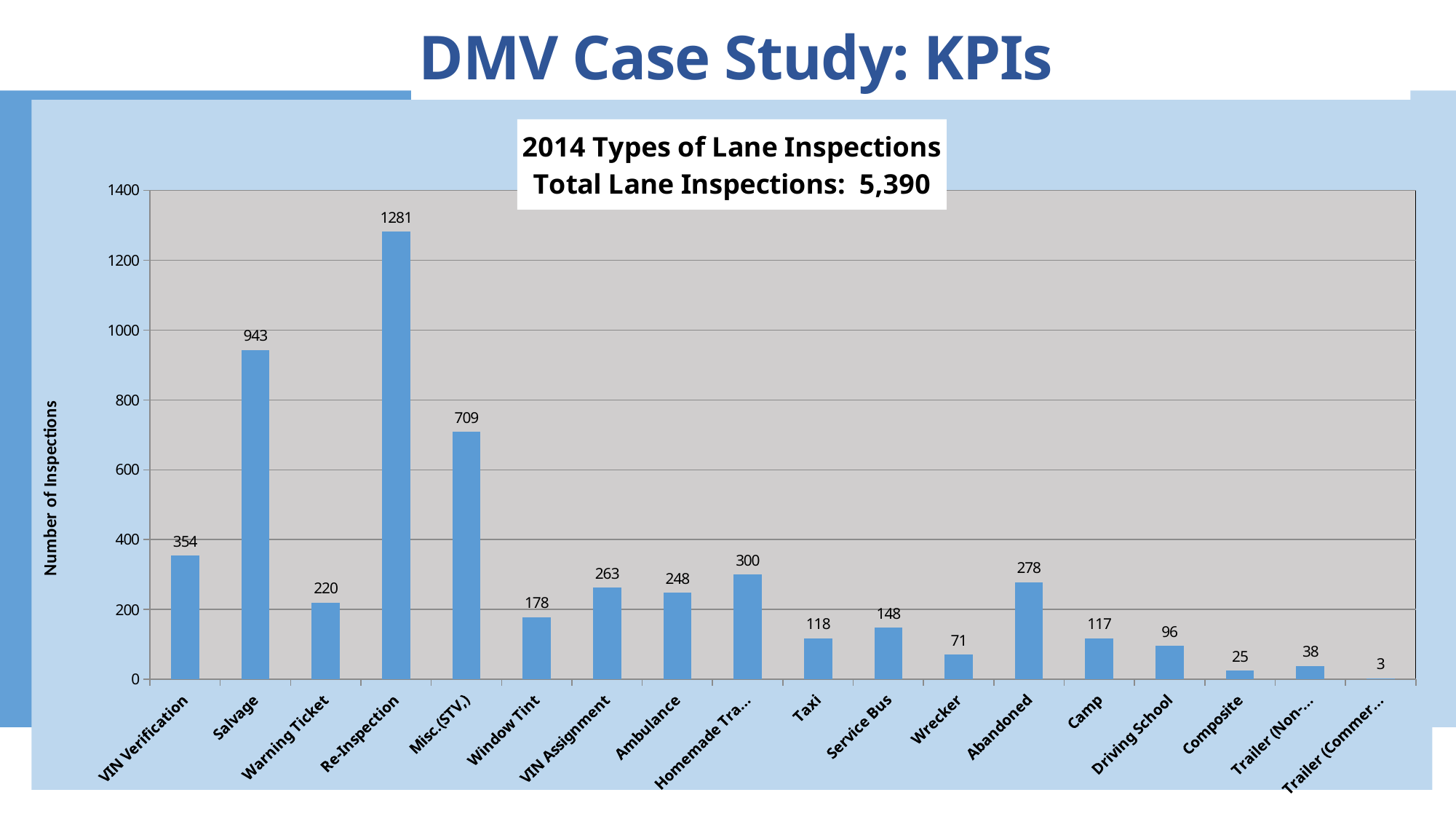
Which has more inspections, VIN Verification or Abandoned? VIN Verification What is the difference between the values for Re-Inspection and Salvage? 338 Which category has the lowest number of inspections? Trailer (Commer... What is the number of inspections for Wrecker? 71 What is the value for Re-Inspection? 1281 What is the title of the chart? 2014 Types of Lane Inspections Total Lane Inspections: 5,390 What type of chart is shown on the slide? bar chart Which category has the highest number of inspections? Re-Inspection How many inspections are shown for Salvage? 943 What is the label of the y axis? Number of Inspections How many categories are shown on the x axis? 18 What is the difference between the values for Ambulance and Taxi? 130